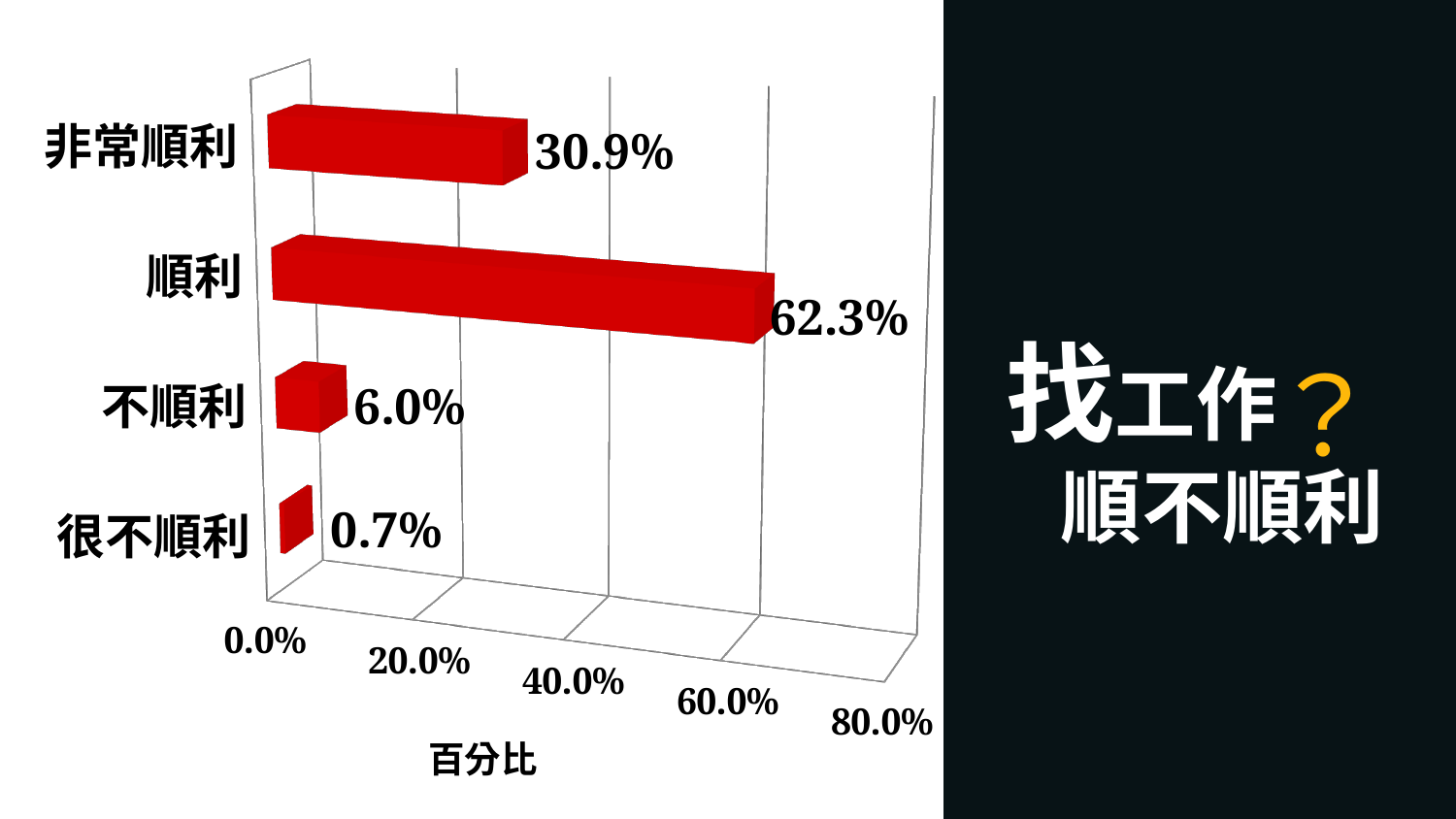
Which is larger, the value for 非常順利 or the value for 不順利? 非常順利 What is the value for 不順利? 6.0% What is the value for 順利? 62.3% How many categories are shown in the chart? 4 What is the value for 很不順利? 0.7% Which category has the highest value? 順利 What is the value for 非常順利? 30.9% Which category has the lowest value? 很不順利 What is the difference between the values for 順利 and 非常順利? 31.4% What is the label of the horizontal axis? 百分比 What is the difference between the values for 不順利 and 很不順利? 5.3% What kind of chart is shown on the slide? Bar chart